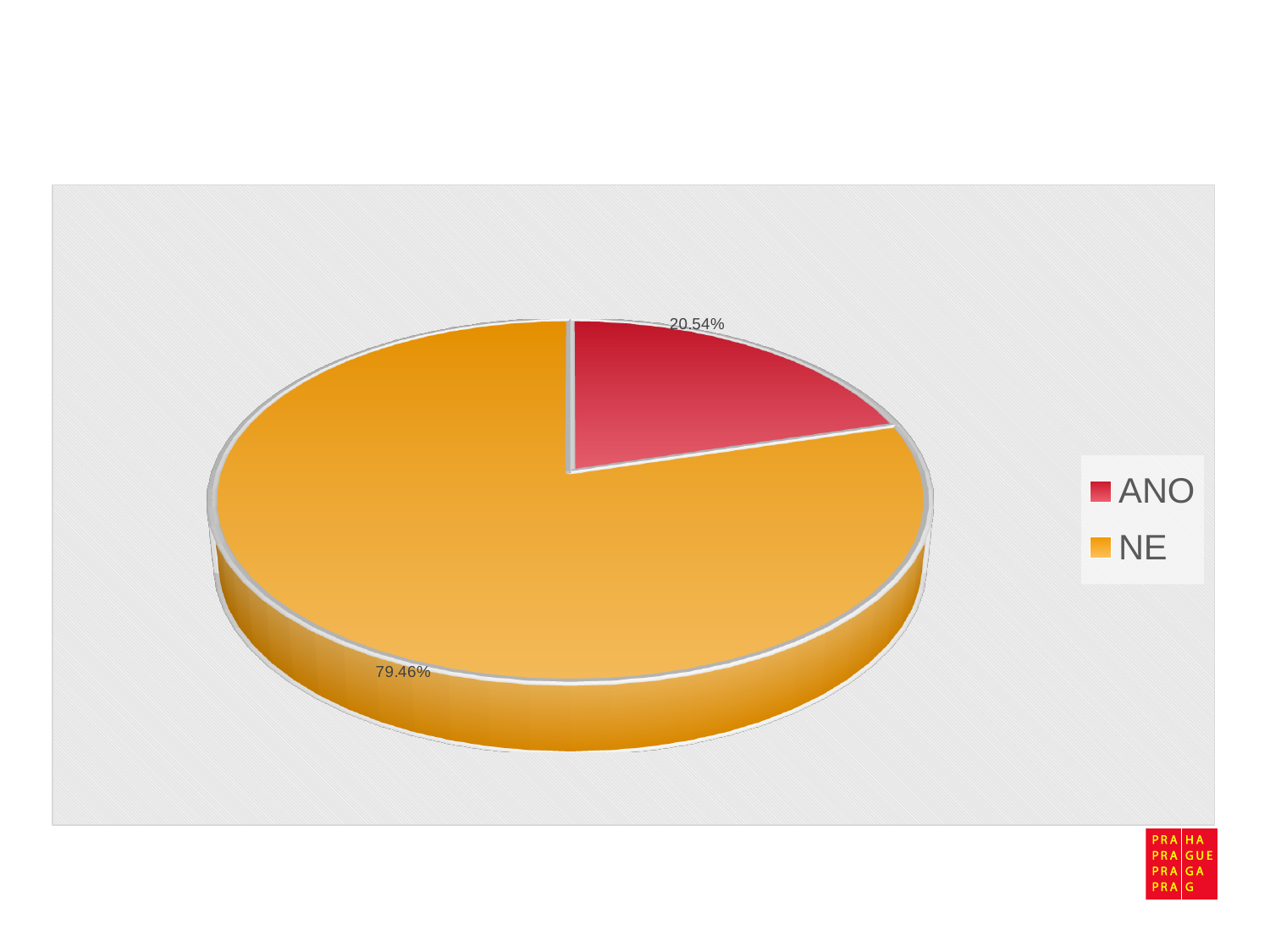
How many entries does the legend list? 2 Which slice is the largest? NE What percentage is shown for the NE slice? 79.46% How many slices does the pie chart have? 2 What is the difference in percentage points between the NE slice and the ANO slice? 58.92 What colour is the ANO slice? red Is the value for NE greater or less than 50%? greater What colour is the NE slice? orange What kind of chart is shown on the slide? pie chart Which is larger, the ANO slice or the NE slice? NE Which slice is the smallest? ANO What percentage is shown for the ANO slice? 20.54%